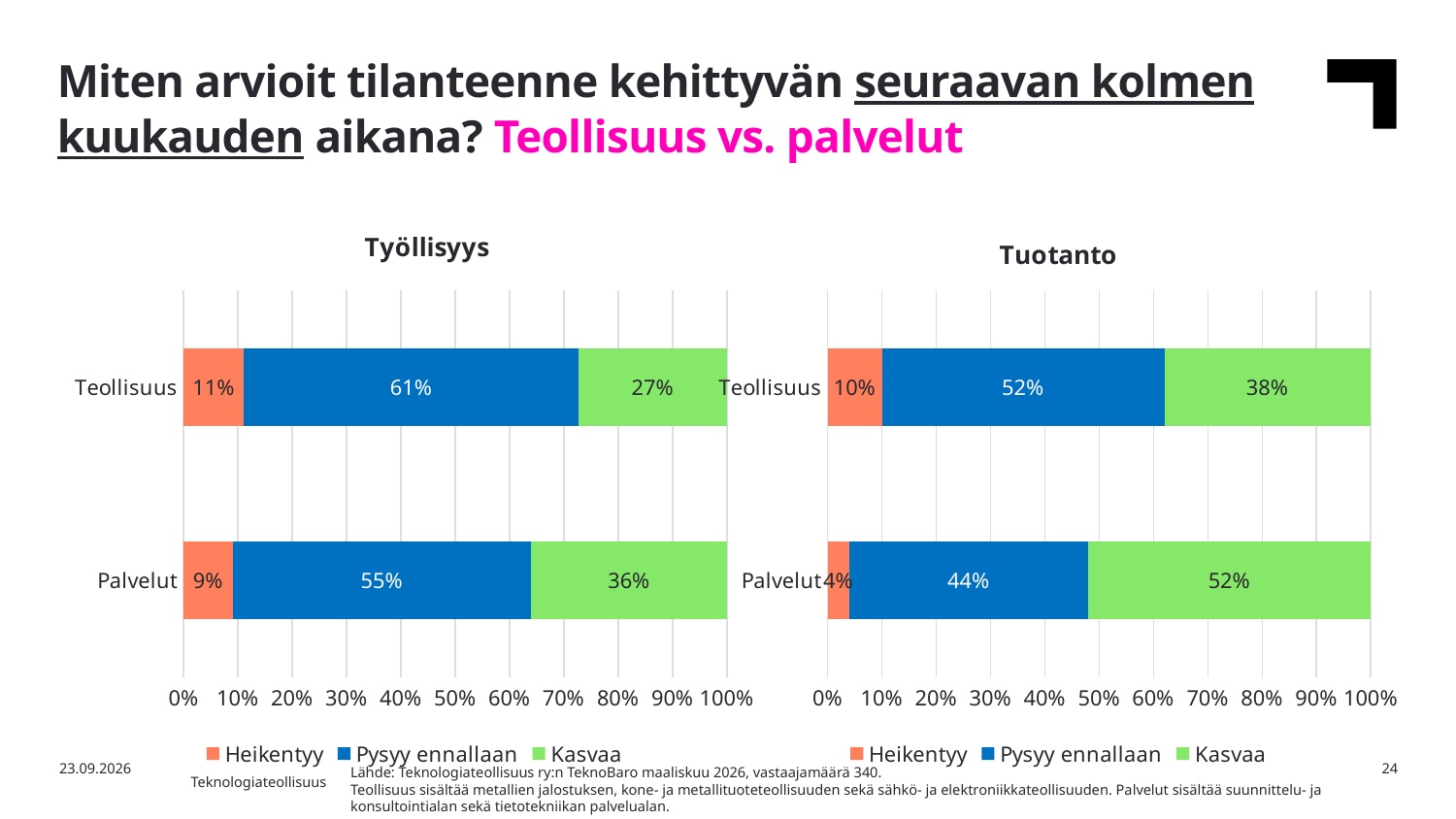
How many categories are shown in the Tuotanto chart? 2 In the Työllisyys chart, which category has the lowest Heikentyy value? Palvelut In the Tuotanto chart, what is the Heikentyy value for Palvelut? 4% In the Tuotanto chart, what is the Kasvaa value for Teollisuus? 38% In the Tuotanto chart, which category has the higher Pysyy ennallaan value? Teollisuus In the Tuotanto chart, what is the difference between the Kasvaa values for Palvelut and Teollisuus? 14% How many series does the legend of the Työllisyys chart list? 3 In the Työllisyys chart, what is the Kasvaa value for Palvelut? 36% What kind of chart is the Työllisyys chart? Stacked bar chart In the Tuotanto chart, what is the total of the stacked bar for Palvelut? 100% In the Työllisyys chart, which category has the larger Kasvaa value, Teollisuus or Palvelut? Palvelut In the Työllisyys chart, what is the Pysyy ennallaan value for Teollisuus? 61%